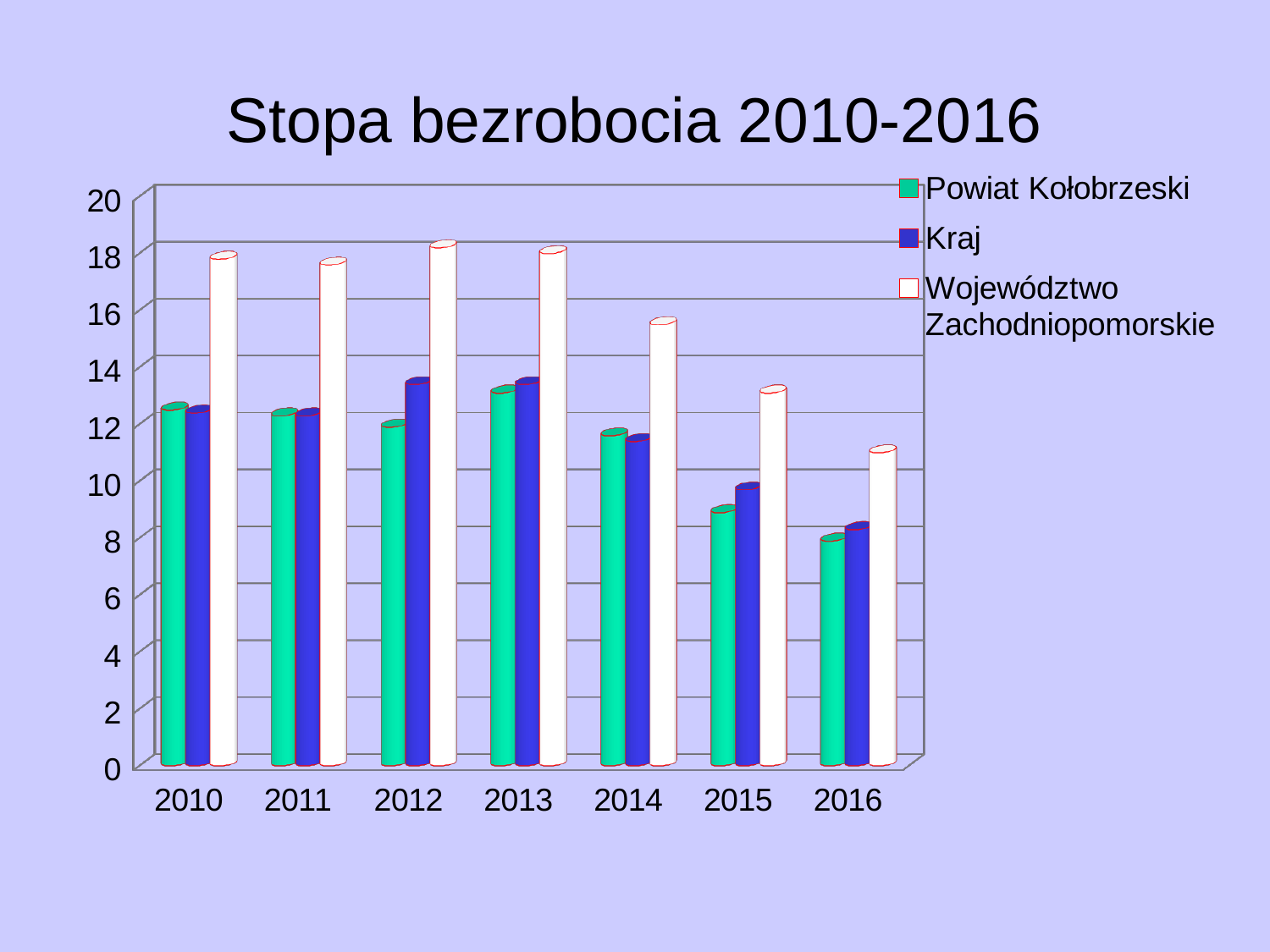
Do the values for Województwo Zachodniopomorskie rise or fall from 2013 to 2016? fall How many series does the legend list? 3 What kind of chart is shown on the slide? bar chart In 2012, which is larger: Kraj or Powiat Kołobrzeski? Kraj In which year is the value for Powiat Kołobrzeski highest? 2013 Which series is drawn with white bars? Województwo Zachodniopomorskie How many years are shown on the x axis? 7 In which year is the value for Powiat Kołobrzeski lowest? 2016 Is the value for Województwo Zachodniopomorskie in 2016 greater or less than 10? greater In which year is the value for Województwo Zachodniopomorskie lowest? 2016 What is the title of the chart? Stopa bezrobocia 2010-2016